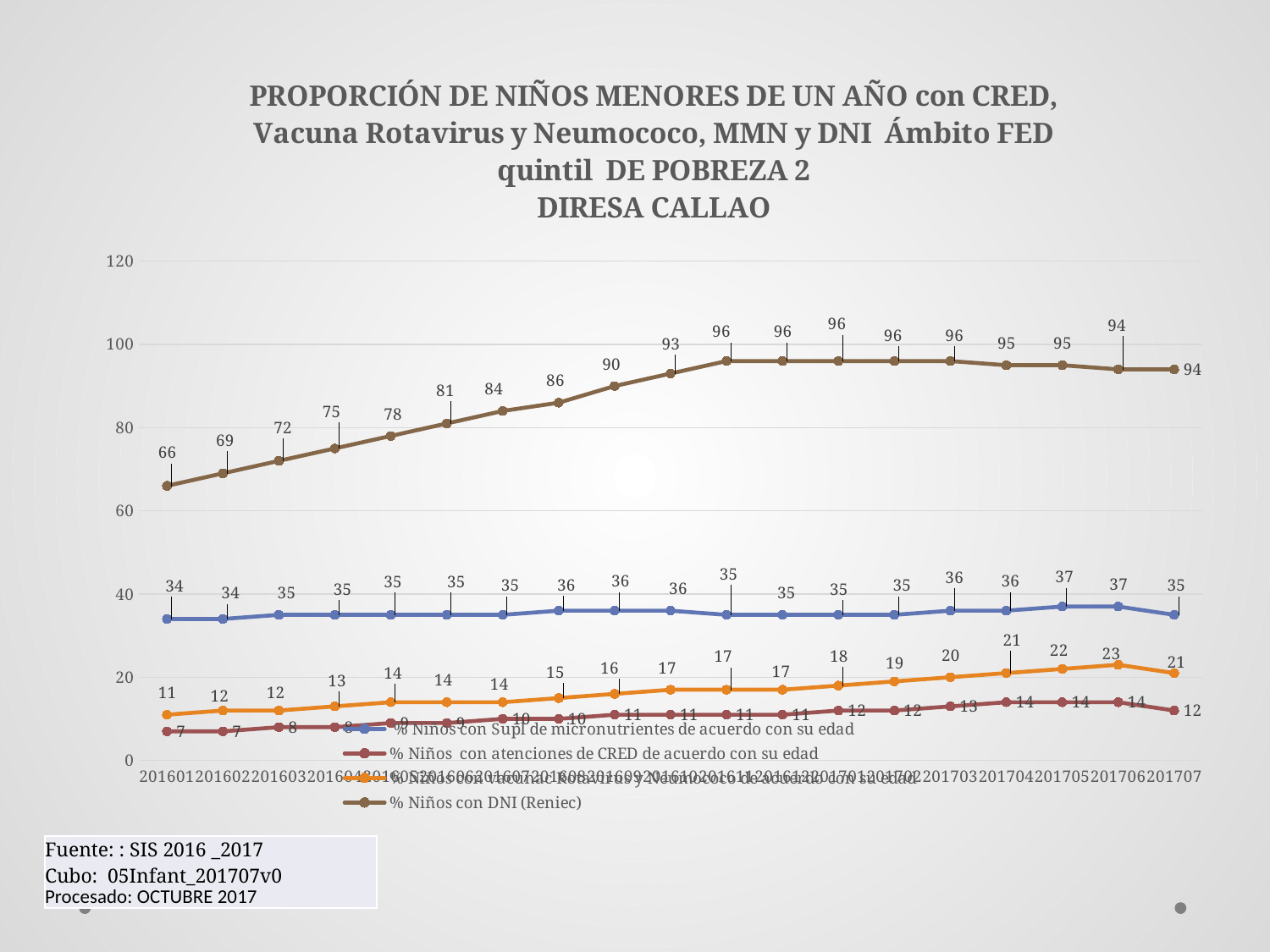
What is the difference between the % Niños con DNI (Reniec) values at 201707 and 201601? 28 Is the value for % Niños con DNI (Reniec) at 201601 greater or less than 60? greater What is the highest value reached by the % Niños con DNI (Reniec) series? 96 What is the value of % Niños con DNI (Reniec) at 201707? 94 How many periods are plotted along the x axis? 19 What is the value of % Niños con Vacuna Rotavirus y Neumococo de acuerdo con su edad at 201706? 23 In which period is the % Niños con DNI (Reniec) series at its lowest? 201601 What kind of chart is shown on the slide? line chart What is the value of % Niños con Supl de micronutrientes de acuerdo con su edad at 201705? 37 At 201707, which series has the larger value: % Niños con DNI (Reniec) or % Niños con Supl de micronutrientes de acuerdo con su edad? % Niños con DNI (Reniec) How many series does the legend list? 4 What is the value of % Niños con DNI (Reniec) at 201601? 66